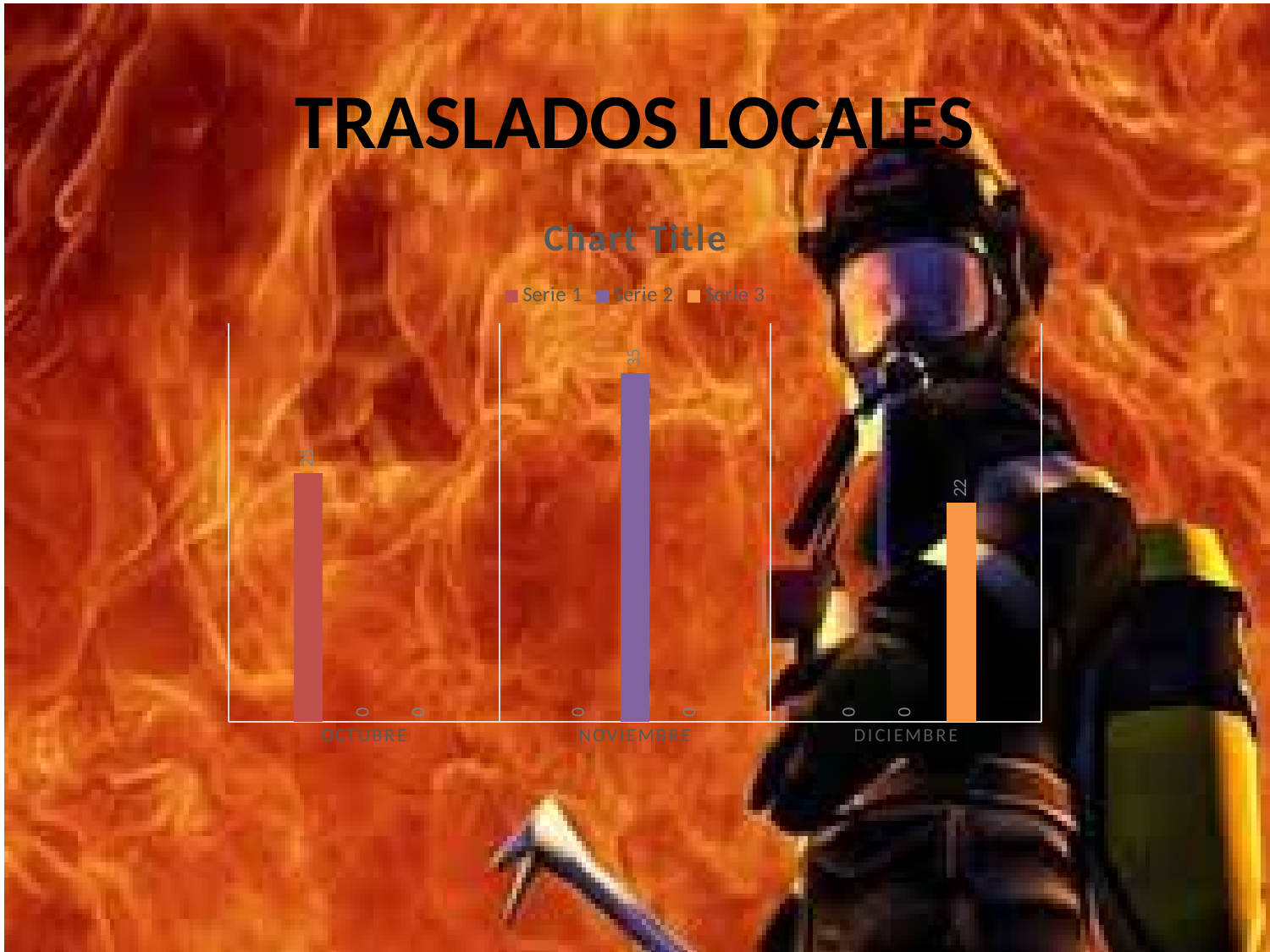
What kind of chart is shown on the slide? Bar chart What is the value for Serie 3 in DICIEMBRE? 22 What is the value for Serie 2 in NOVIEMBRE? 35 How many categories are shown on the x axis? 3 What is the difference between the Serie 2 value in NOVIEMBRE and the Serie 3 value in DICIEMBRE? 13 What is the value for Serie 1 in NOVIEMBRE? 0 Which month has the lowest non-zero plotted value? DICIEMBRE Which month has the highest plotted value? NOVIEMBRE What is the difference between the Serie 1 value in OCTUBRE and the Serie 3 value in DICIEMBRE? 3 How many series does the legend list? 3 What is the value for Serie 1 in OCTUBRE? 25 Which is larger: the Serie 1 value in OCTUBRE or the Serie 2 value in NOVIEMBRE? Serie 2 in NOVIEMBRE